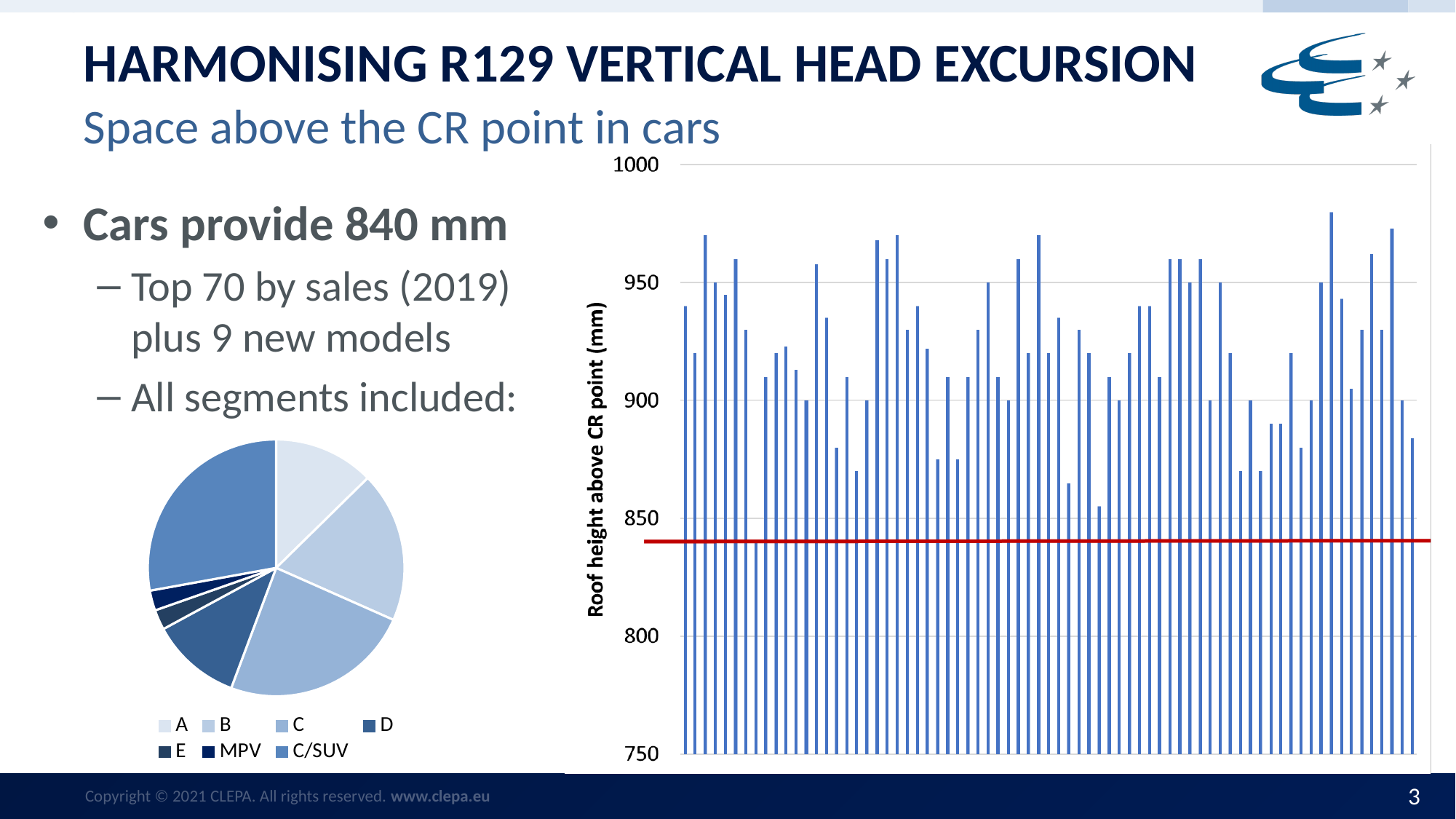
What kind of chart is the chart on the right of the slide? bar chart How many car models are represented in the bar chart on the right? 79 How many segments does the legend of the pie chart list? 7 In the pie chart, which slice is larger, A or C/SUV? C/SUV What is the label of the vertical axis of the bar chart on the right? Roof height above CR point (mm) In the bar chart on the right, what value does the red horizontal line mark? 840 mm In the pie chart, which slice is larger, A or B? B In the bar chart on the right, is the shortest bar greater or less than 900? less In the bar chart on the right, is the tallest bar greater or less than 950? greater In the pie chart, which segment has the largest slice? C/SUV In the pie chart, which slice is larger, C or D? C What kind of chart is the chart on the left of the slide? pie chart